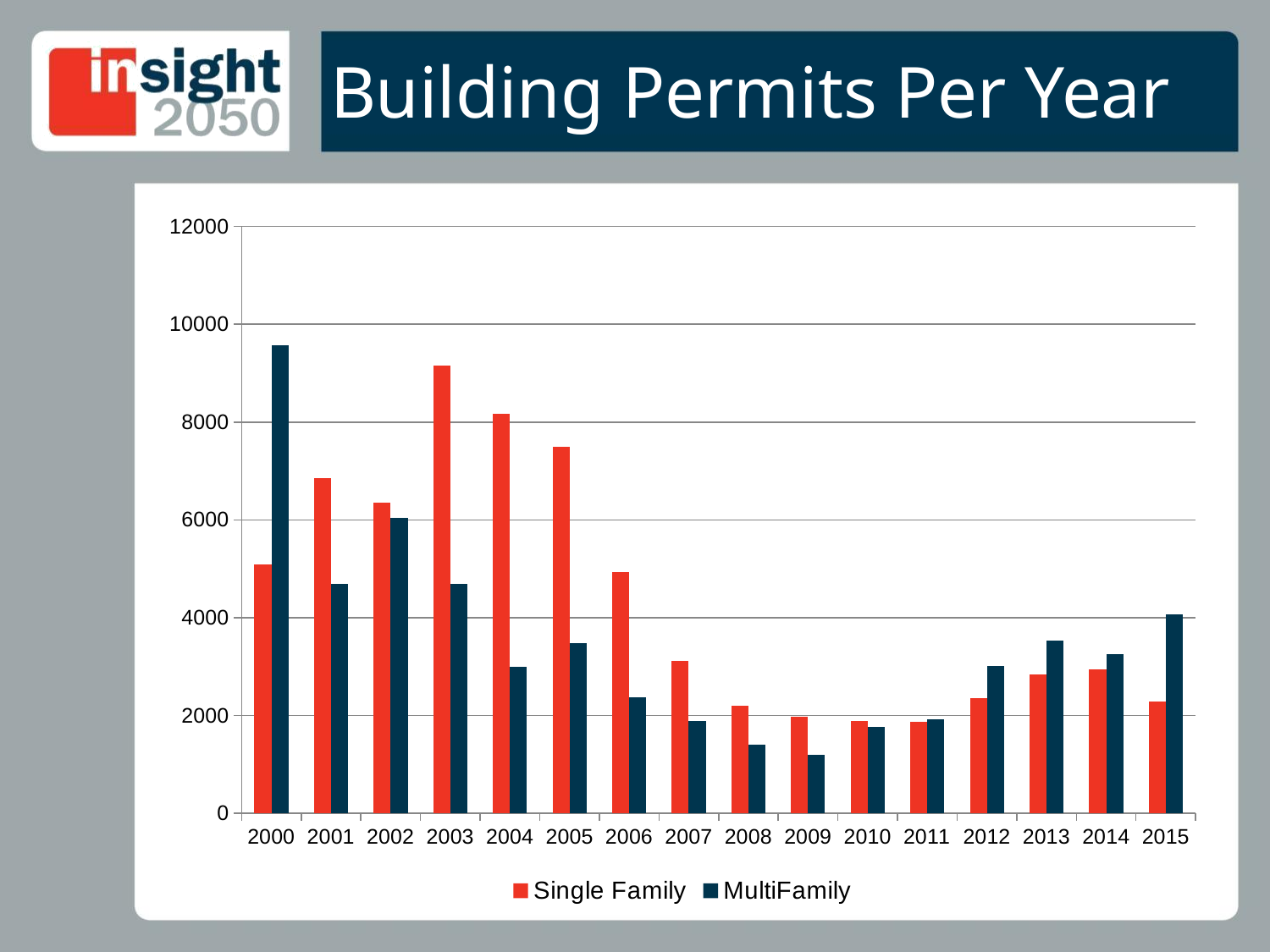
What kind of chart is shown on the slide? bar chart In which year is the Single Family value highest? 2003 Do the Single Family values rise or fall from 2003 to 2009? fall In which year is the MultiFamily value lowest? 2009 Is the Single Family value for 2003 greater or less than 8000? greater In 2000, which is larger: Single Family or MultiFamily? MultiFamily Is the MultiFamily value for 2004 greater or less than 4000? less How many series does the legend list? 2 Is the MultiFamily value for 2015 greater or less than 3000? greater How many years are shown on the x axis? 16 In 2005, which is larger: Single Family or MultiFamily? Single Family In which year is the MultiFamily value highest? 2000